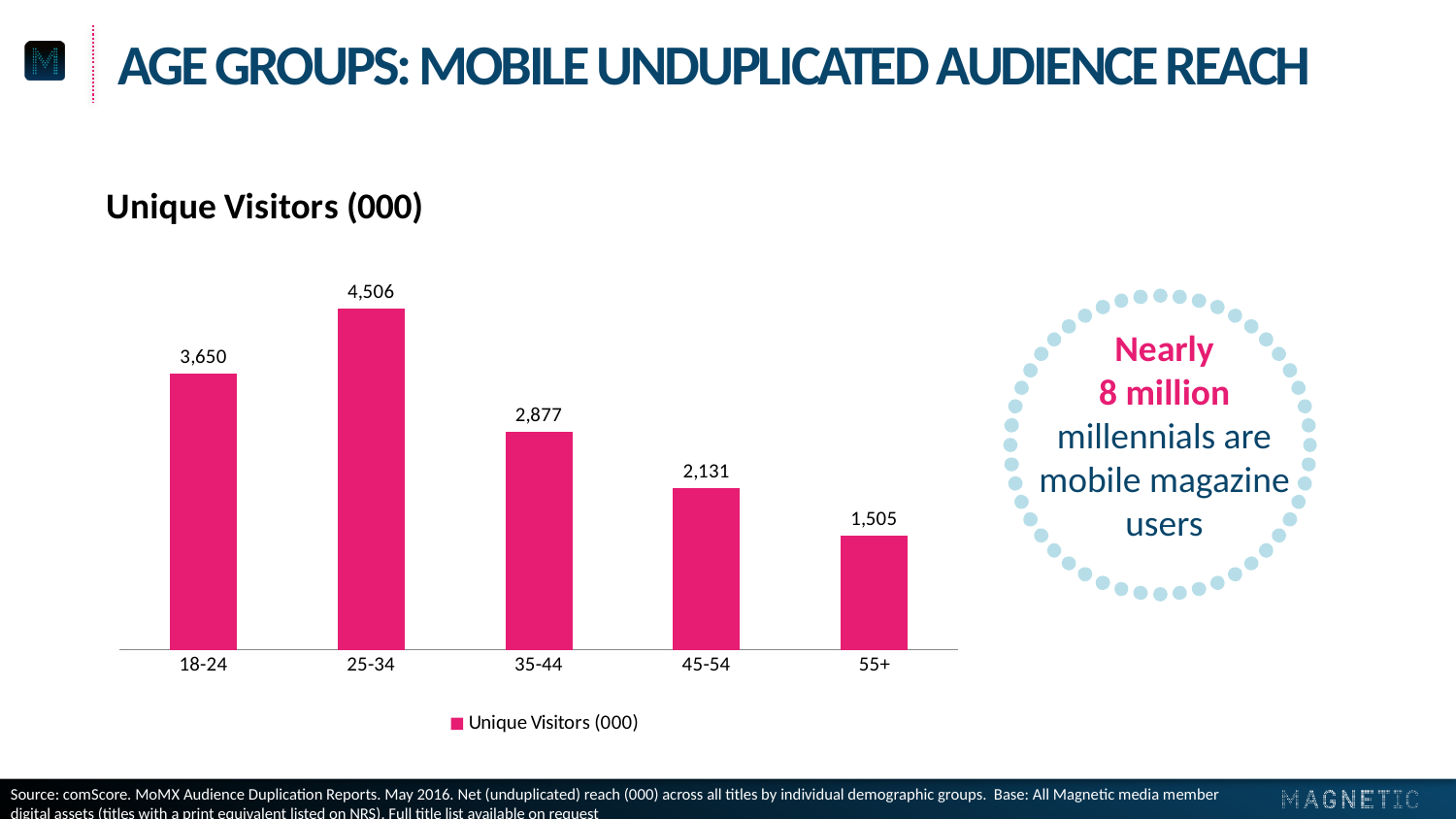
What is the value of Unique Visitors (000) for the 55+ age group? 1,505 What is the value of Unique Visitors (000) for the 35-44 age group? 2,877 How many series does the legend list? 1 What is the value of Unique Visitors (000) for the 25-34 age group? 4,506 What is the difference in Unique Visitors (000) between the 25-34 and 18-24 age groups? 856 Which age group has the lowest number of unique visitors? 55+ Which age group has more unique visitors, 18-24 or 35-44? 18-24 What is the title of the chart? Unique Visitors (000) How many age groups are shown in the chart? 5 What is the difference in Unique Visitors (000) between the 45-54 and 55+ age groups? 626 What kind of chart is shown on the slide? Bar chart Which age group has the highest number of unique visitors? 25-34